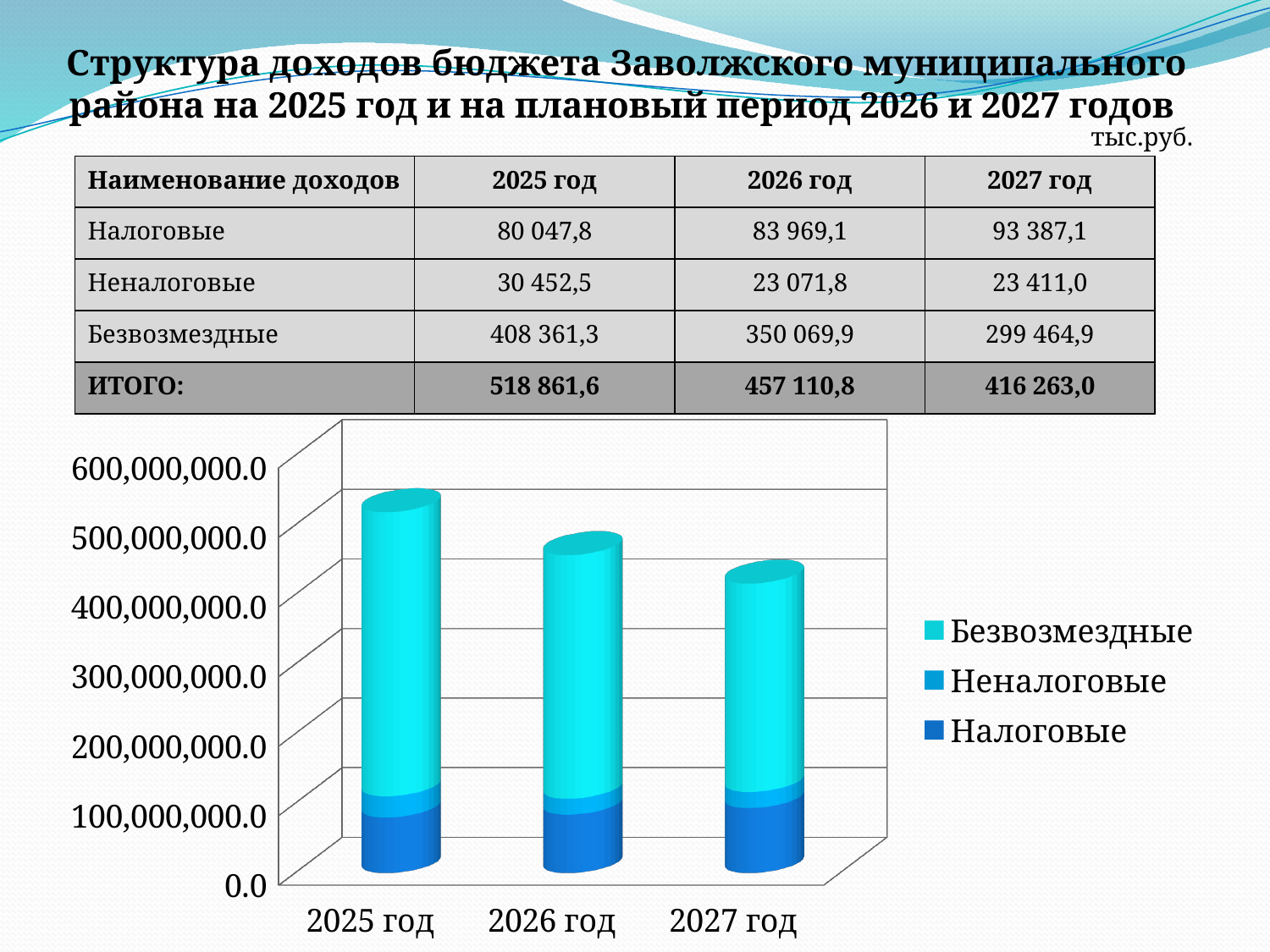
Which year has the tallest stacked bar in the chart? 2025 год Do the total bar heights rise or fall from 2025 год to 2027 год? Fall Which year has the shortest stacked bar in the chart? 2027 год Is the total bar for 2025 год greater or less than 400,000,000.0? greater How many years (categories) are plotted on the x axis of the chart? 3 Which series is shown at the bottom of each stacked bar? Налоговые In the 2025 год bar, which segment is larger: Безвозмездные or Налоговые? Безвозмездные What are the three entries in the chart legend? Безвозмездные, Неналоговые, Налоговые What kind of chart is shown on the slide? Stacked bar chart Is the total bar for 2026 год greater or less than 400,000,000.0? greater How many series does the chart legend list? 3 Is the total bar for 2027 год greater or less than 500,000,000.0? less